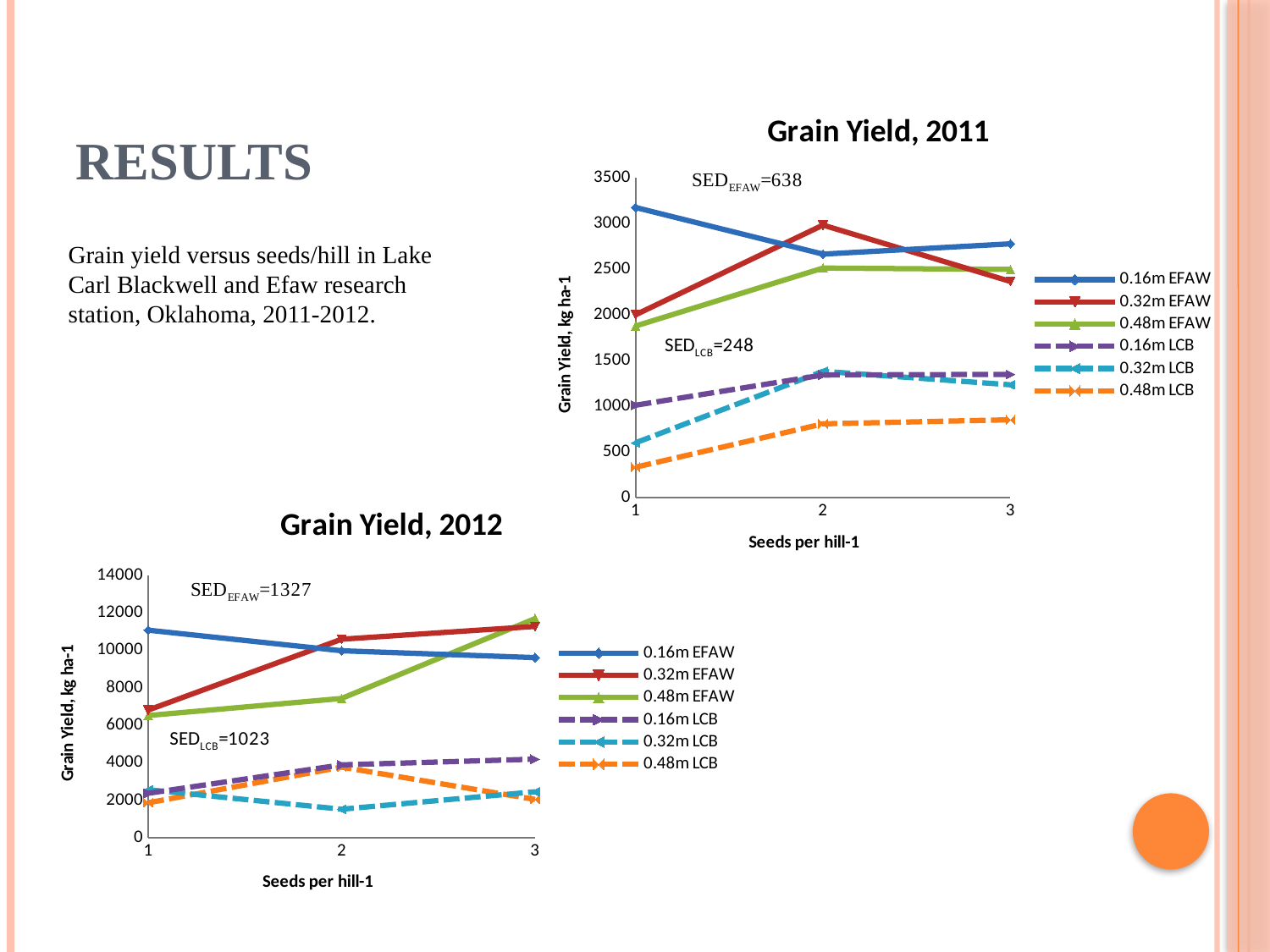
In the Grain Yield, 2012 chart, what SED value is given for EFAW? 1327 In the Grain Yield, 2011 chart, is the value for 0.16m EFAW at 1 seed per hill greater or less than 3000? greater In the Grain Yield, 2012 chart, does the 0.16m EFAW line rise or fall from 1 to 3 seeds per hill? fall In the Grain Yield, 2012 chart, at 3 seeds per hill, which is larger: 0.16m EFAW or 0.32m EFAW? 0.32m EFAW In the Grain Yield, 2012 chart, is the value for 0.16m EFAW at 1 seed per hill greater or less than 10000? greater In the Grain Yield, 2012 chart, does the 0.48m EFAW line rise or fall from 1 to 3 seeds per hill? rise In the Grain Yield, 2011 chart, what kind of chart is used? line chart In the Grain Yield, 2012 chart, how many seeds-per-hill levels are plotted on the x axis? 3 In the Grain Yield, 2011 chart, which series has the highest grain yield at 1 seed per hill? 0.16m EFAW In the Grain Yield, 2011 chart, how many series does the legend list? 6 In the Grain Yield, 2011 chart, is the value for 0.48m LCB at 1 seed per hill greater or less than 500? less In the Grain Yield, 2011 chart, which series has the lowest grain yield at 1 seed per hill? 0.48m LCB